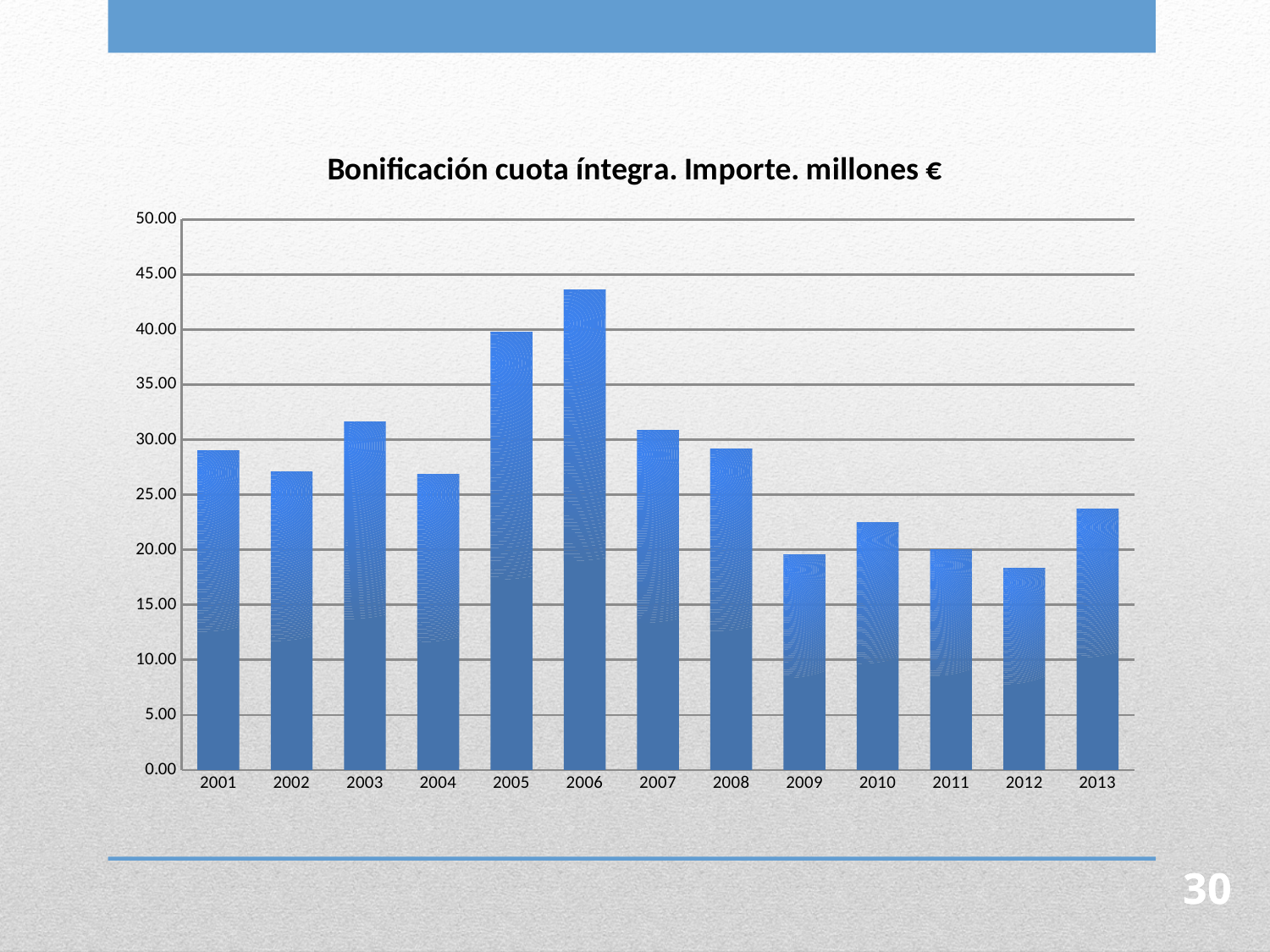
Is the value for 2001 greater or less than 25.00? greater Is the value for 2013 greater or less than 25.00? less What is the title of the chart? Bonificación cuota íntegra. Importe. millones € Which year has a larger value, 2005 or 2007? 2005 What type of chart is shown on the slide? Bar chart How many years are shown on the x axis of the chart? 13 Which year has the highest value in the chart? 2006 Which year has the lowest value in the chart? 2012 Do the values rise or fall from 2006 to 2009? fall Which year has a larger value, 2003 or 2004? 2003 Is the value for 2006 greater or less than 40.00? greater